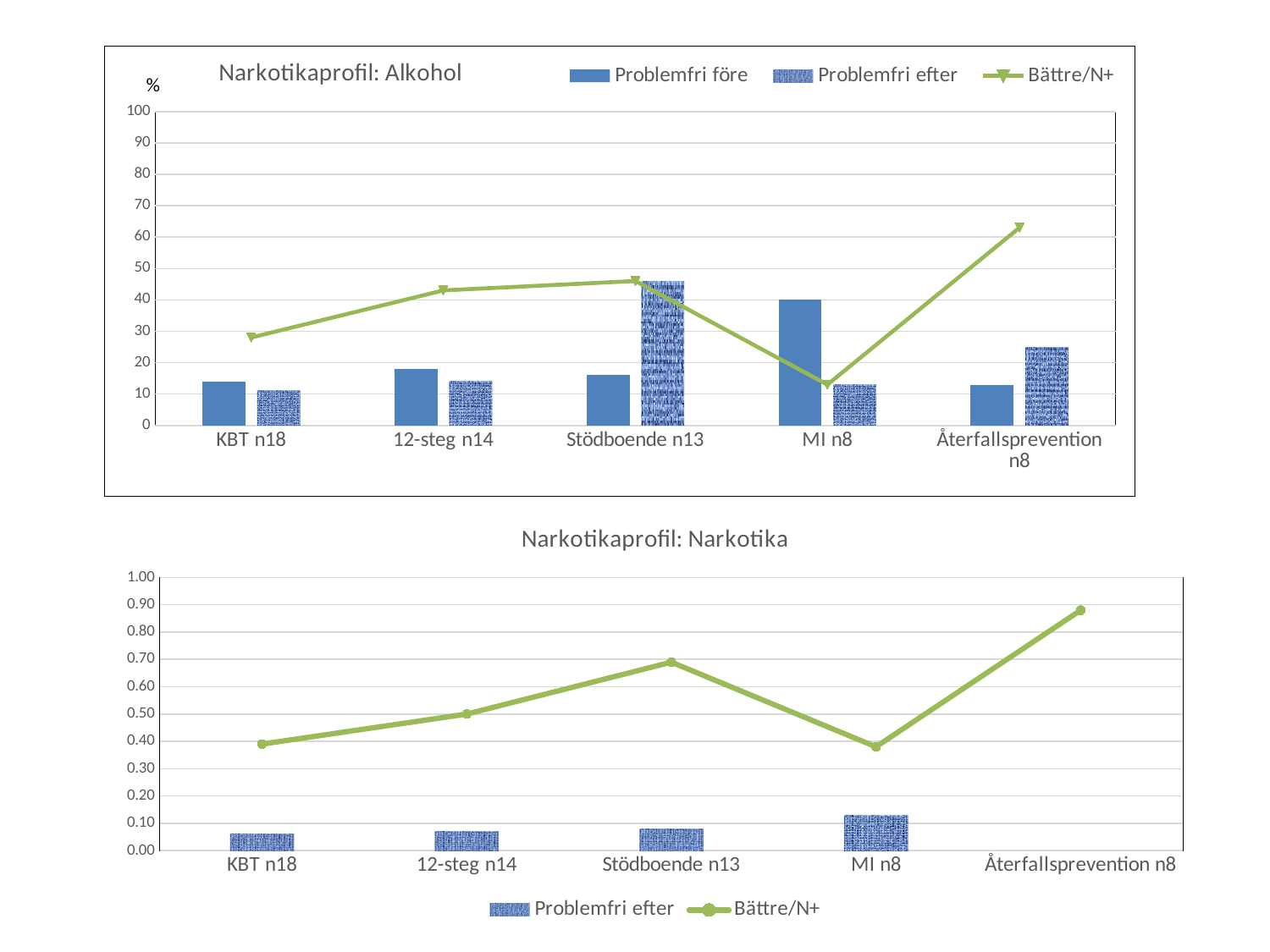
How many series does the legend of the 'Narkotikaprofil: Alkohol' chart list? 3 In the 'Narkotikaprofil: Alkohol' chart, is the Problemfri efter value for Stödboende n13 greater or less than 40? greater In the 'Narkotikaprofil: Alkohol' chart, which category has the highest Problemfri före value? MI n8 In the 'Narkotikaprofil: Alkohol' chart, is the Problemfri före value for MI n8 greater or less than 30? greater In the 'Narkotikaprofil: Narkotika' chart, which category has the highest Bättre/N+ value? Återfallsprevention n8 In the 'Narkotikaprofil: Alkohol' chart, is the Bättre/N+ value for Återfallsprevention n8 greater or less than 60? greater In the 'Narkotikaprofil: Narkotika' chart, which category has the highest Problemfri efter value? MI n8 In the 'Narkotikaprofil: Narkotika' chart, which has the larger Bättre/N+ value, 12-steg n14 or MI n8? 12-steg n14 How many categories are shown on the x axis of the 'Narkotikaprofil: Alkohol' chart? 5 How many series does the legend of the 'Narkotikaprofil: Narkotika' chart list? 2